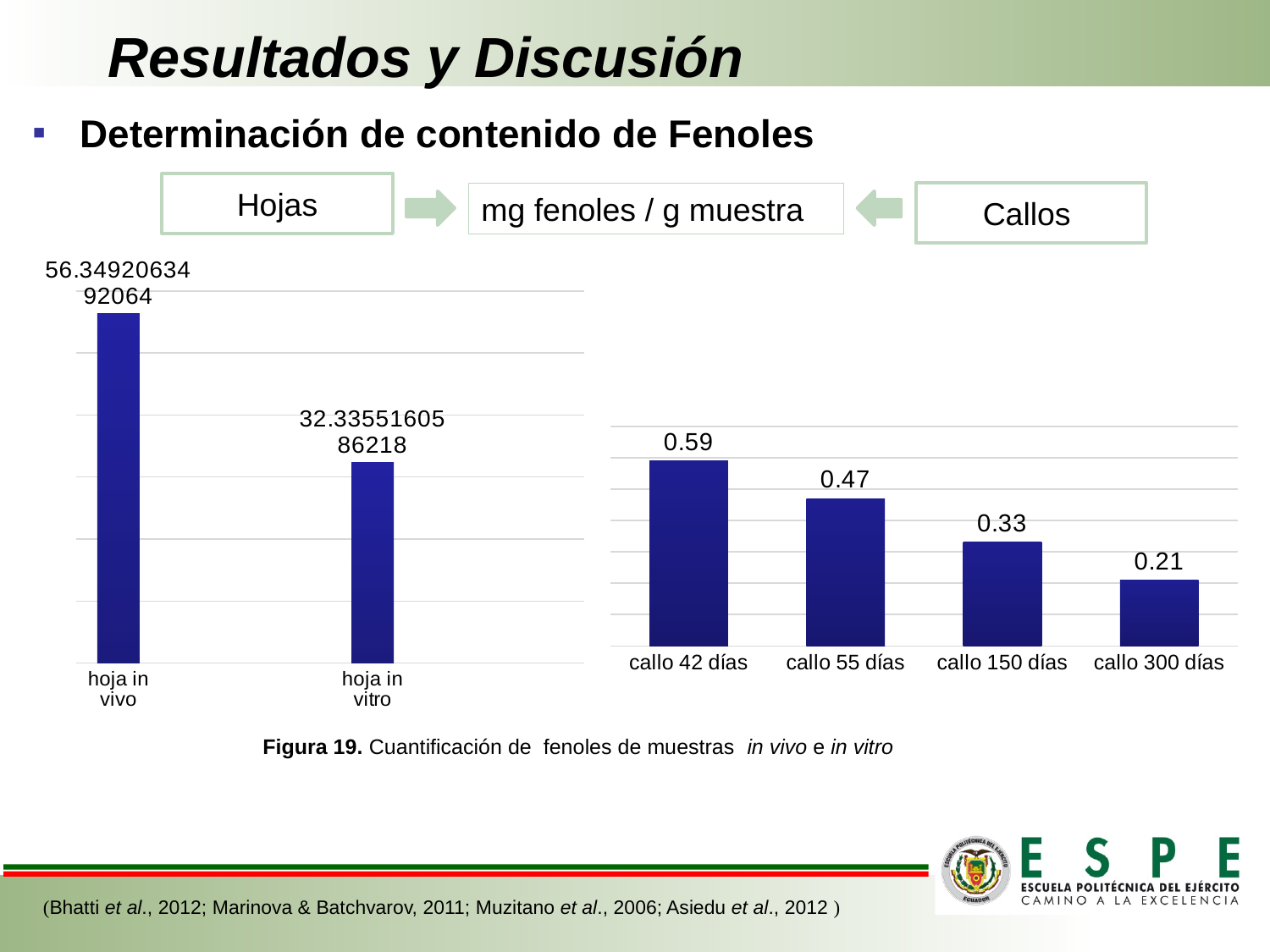
How many categories are shown in the Hojas chart on the left? 2 In the Callos chart on the right, what is the difference between callo 42 días and callo 55 días? 0.12 In the Hojas chart on the left, which category has the higher value, hoja in vivo or hoja in vitro? hoja in vivo In the Callos chart on the right, which category has the lowest value? callo 300 días In the Callos chart on the right, do the values rise or fall from callo 42 días to callo 300 días? fall What type of chart is the Hojas chart on the left? bar chart In the Callos chart on the right, what is the value for callo 300 días? 0.21 In the Callos chart on the right, what is the difference between callo 42 días and callo 300 días? 0.38 In the Callos chart on the right, which category has the highest value? callo 42 días In the Callos chart on the right, what is the value for callo 42 días? 0.59 In the Callos chart on the right, what is the value for callo 150 días? 0.33 How many categories are shown in the Callos chart on the right? 4